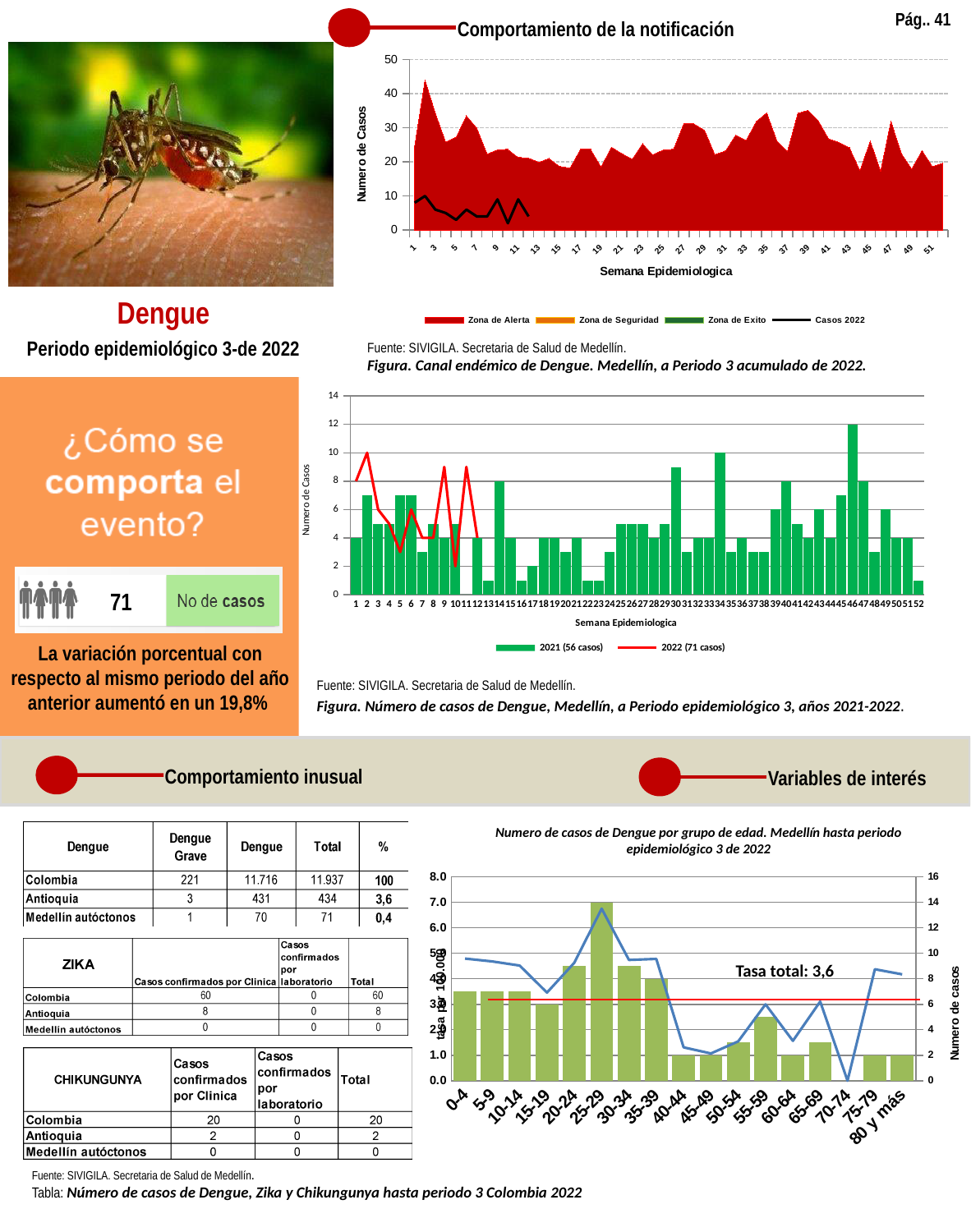
In the chart titled 'Número de casos de Dengue por grupo de edad', which age group has the highest bar? 25-29 In the middle chart 'Número de casos de Dengue, Medellín, a Periodo epidemiológico 3, años 2021-2022', how many cases does the legend give for 2022? 71 casos In the chart titled 'Número de casos de Dengue por grupo de edad', how many age groups are shown on the x axis? 17 In the chart titled 'Número de casos de Dengue por grupo de edad', is the bar for 40-44 greater or less than 4? less In the chart titled 'Número de casos de Dengue por grupo de edad', is the bar for 25-29 greater or less than 6? greater In the chart titled 'Número de casos de Dengue por grupo de edad', which bar is taller, 20-24 or 45-49? 20-24 In the chart titled 'Número de casos de Dengue por grupo de edad', which age group has no bar (the lowest value)? 70-74 In the middle chart 'Número de casos de Dengue, Medellín, a Periodo epidemiológico 3, años 2021-2022', how many series does the legend list? 2 In the middle chart 'Número de casos de Dengue, Medellín, a Periodo epidemiológico 3, años 2021-2022', which week has the tallest 2021 bar? 46 In the chart titled 'Número de casos de Dengue por grupo de edad', what is the 'Tasa total' printed on the chart? 3,6 In the middle chart 'Número de casos de Dengue, Medellín, a Periodo epidemiológico 3, años 2021-2022', what is the difference between the 2022 total (71 casos) and the 2021 total (56 casos) shown in the legend? 15 In the top chart 'Canal endémico de Dengue', how many entries does the legend list? 4